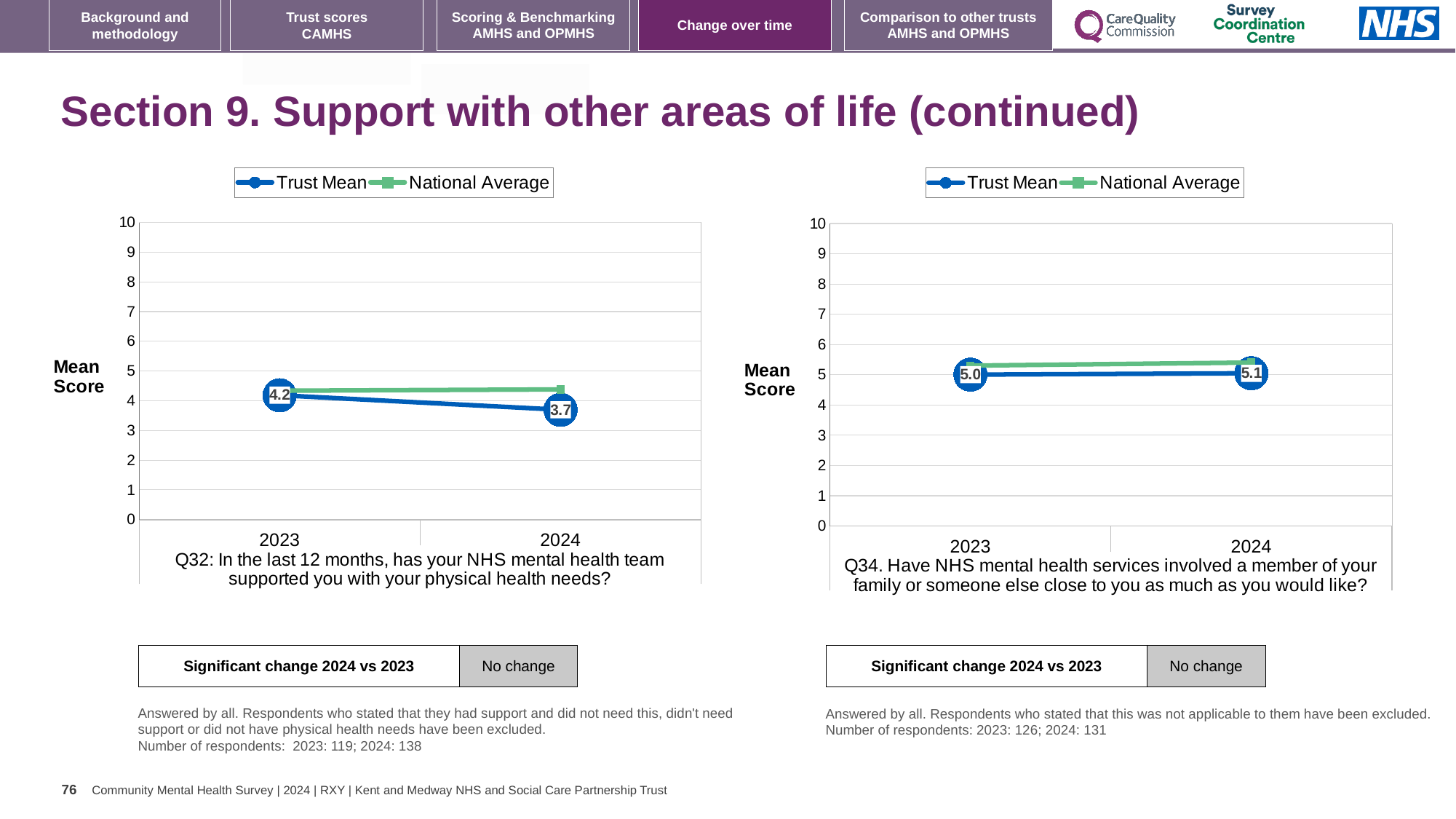
How many years are shown on the x axis of the left chart (Q32)? 2 How many series does the legend of the right chart (Q34) list? 2 In the left chart (Q32), is the National Average for 2024 greater or less than 3? greater In the right chart (Q34), what is the Trust Mean for 2023? 5.0 What type of chart is the left chart (Q32)? line chart In the left chart (Q32), by how much did the Trust Mean change from 2023 to 2024? 0.5 In the right chart (Q34), does the Trust Mean rise or fall from 2023 to 2024? rise In the left chart (Q32), what is the Trust Mean for 2024? 3.7 In the left chart (Q32), which is larger for 2024: the Trust Mean or the National Average? National Average In the right chart (Q34), what is the Trust Mean for 2024? 5.1 In the left chart (Q32), does the Trust Mean rise or fall from 2023 to 2024? fall In the left chart (Q32), what is the Trust Mean for 2023? 4.2